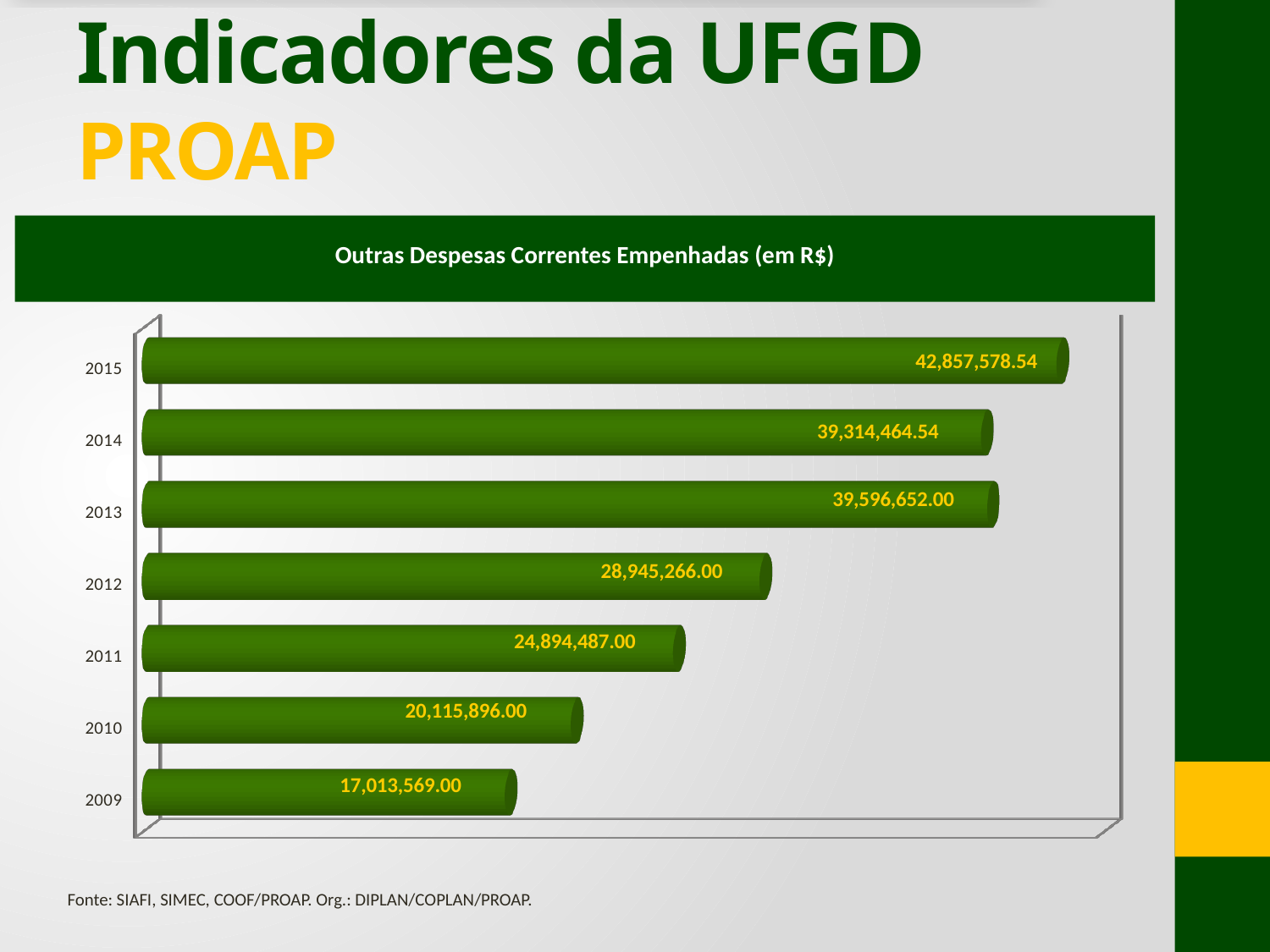
What is the difference between the values for 2010 and 2009? 3,102,327.00 What is the value for 2012 in the chart? 28,945,266.00 What type of chart is shown on the slide? bar chart What is the value for 2011 in the chart? 24,894,487.00 Which year has the highest value in the chart? 2015 What is the value for 2009 in the chart? 17,013,569.00 What is the value for 2015 in the chart? 42,857,578.54 Which year has the lowest value in the chart? 2009 How many years are shown in the chart? 7 What is the difference between the values for 2015 and 2014? 3,543,114.00 Which year has the larger value, 2013 or 2014? 2013 What is the title of the chart? Outras Despesas Correntes Empenhadas (em R$)